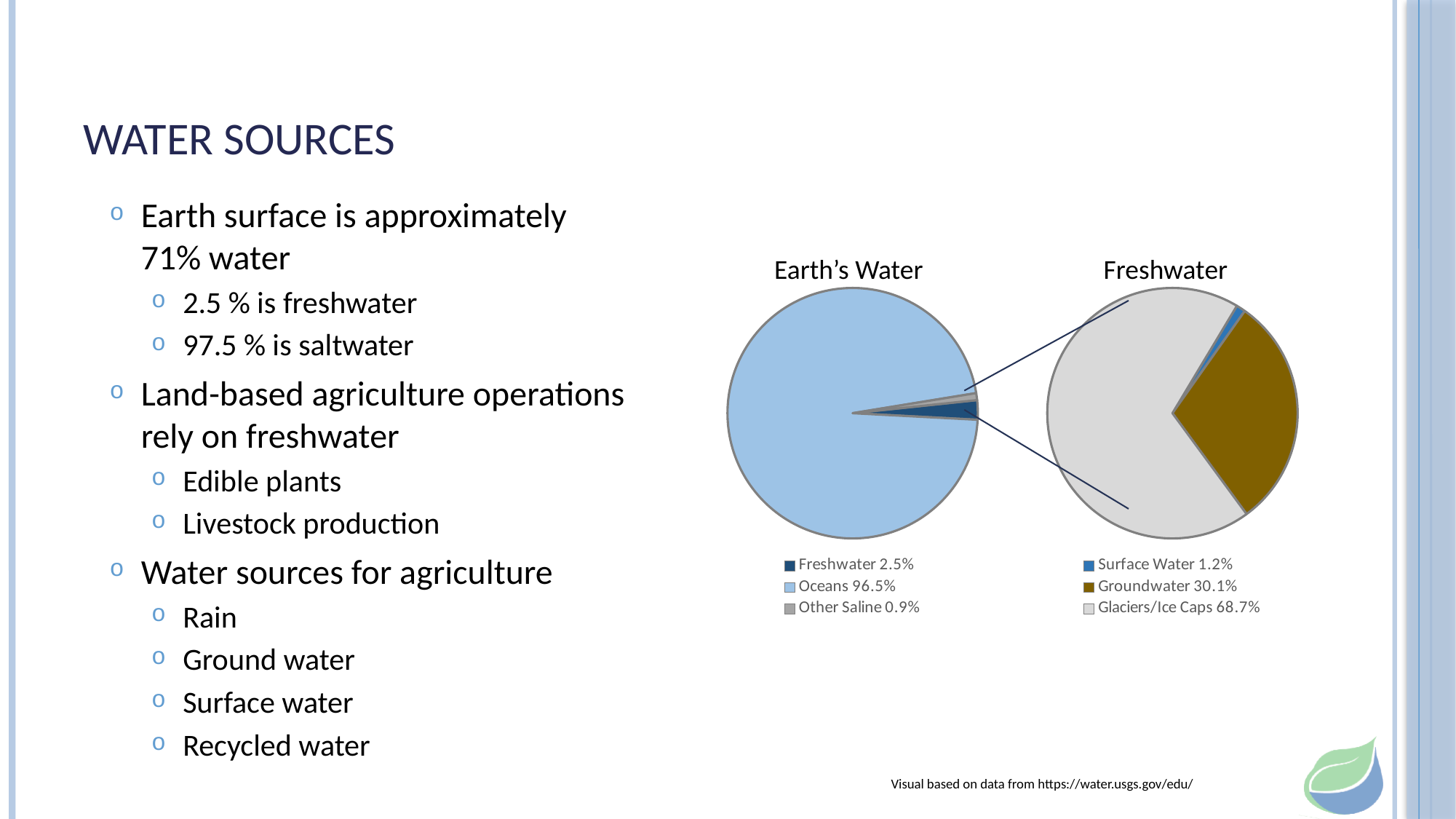
In the Freshwater pie chart, which category has the smallest share? Surface Water In the Earth's Water pie chart, what share is Other Saline? 0.9% In the Freshwater pie chart, what share is Surface Water? 1.2% In the Freshwater pie chart, what is the difference between Glaciers/Ice Caps and Groundwater? 38.6% In the Earth's Water pie chart, what share is Freshwater? 2.5% What type of chart is the Earth's Water chart? Pie chart In the Earth's Water pie chart, which is larger, Freshwater or Other Saline? Freshwater In the Earth's Water pie chart, what share is Oceans? 96.5% In the Freshwater pie chart, what share is Groundwater? 30.1% In the Freshwater pie chart, what share is Glaciers/Ice Caps? 68.7% In the Earth's Water pie chart, which category has the largest share? Oceans How many categories does the Freshwater pie chart's legend list? 3